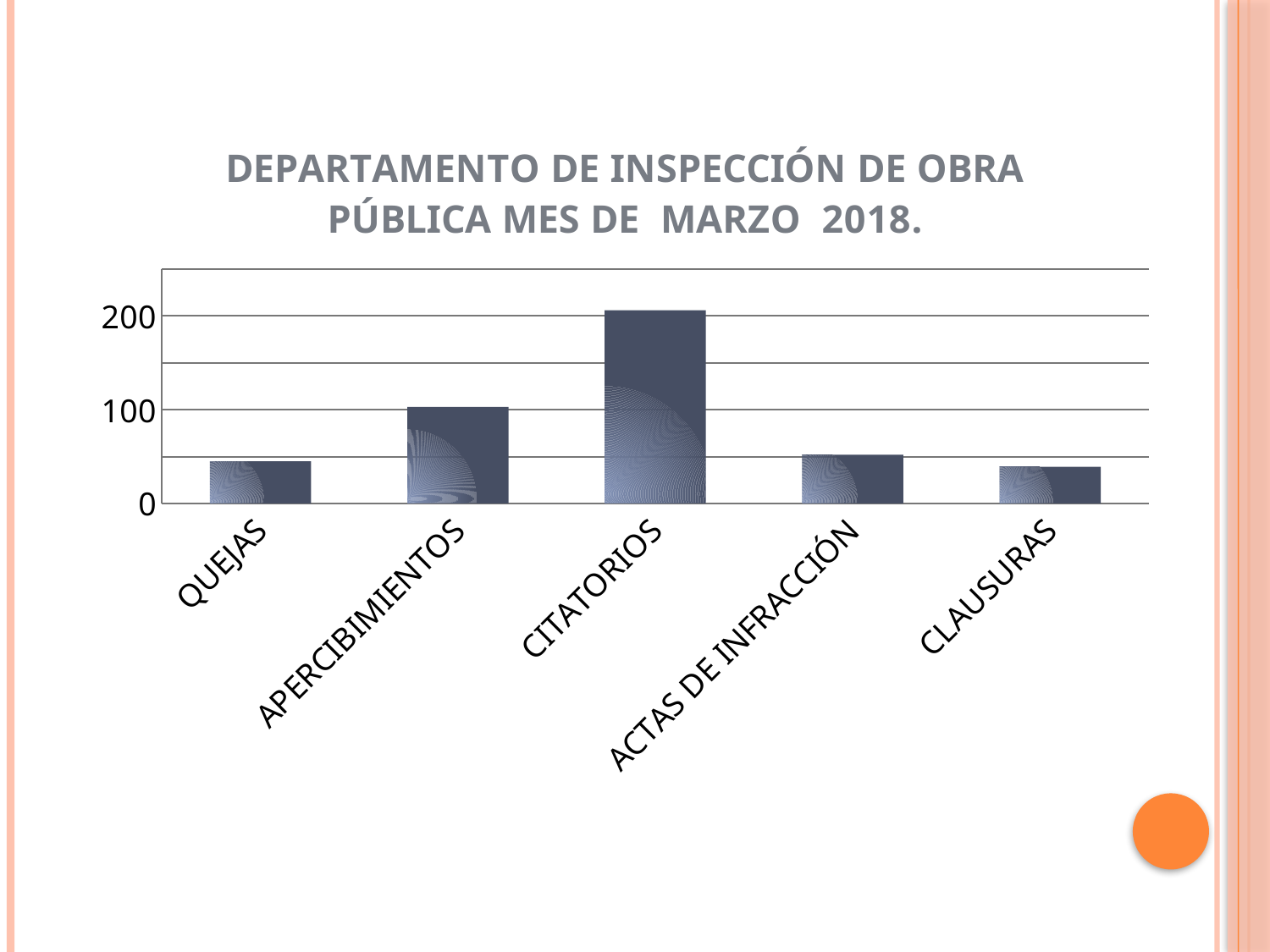
Is the value for QUEJAS greater or less than 100? less What kind of chart is shown on the slide? bar chart Which is larger, the value for CITATORIOS or the value for APERCIBIMIENTOS? CITATORIOS Which is larger, the value for ACTAS DE INFRACCIÓN or the value for CITATORIOS? CITATORIOS What is the title of the chart? DEPARTAMENTO DE INSPECCIÓN DE OBRA PÚBLICA MES DE MARZO 2018. Which is larger, the value for APERCIBIMIENTOS or the value for QUEJAS? APERCIBIMIENTOS Is the value for CLAUSURAS greater or less than 100? less Is the value for CITATORIOS greater or less than 100? greater How many categories are shown on the x axis of the chart? 5 Which category has the highest value in the chart? CITATORIOS